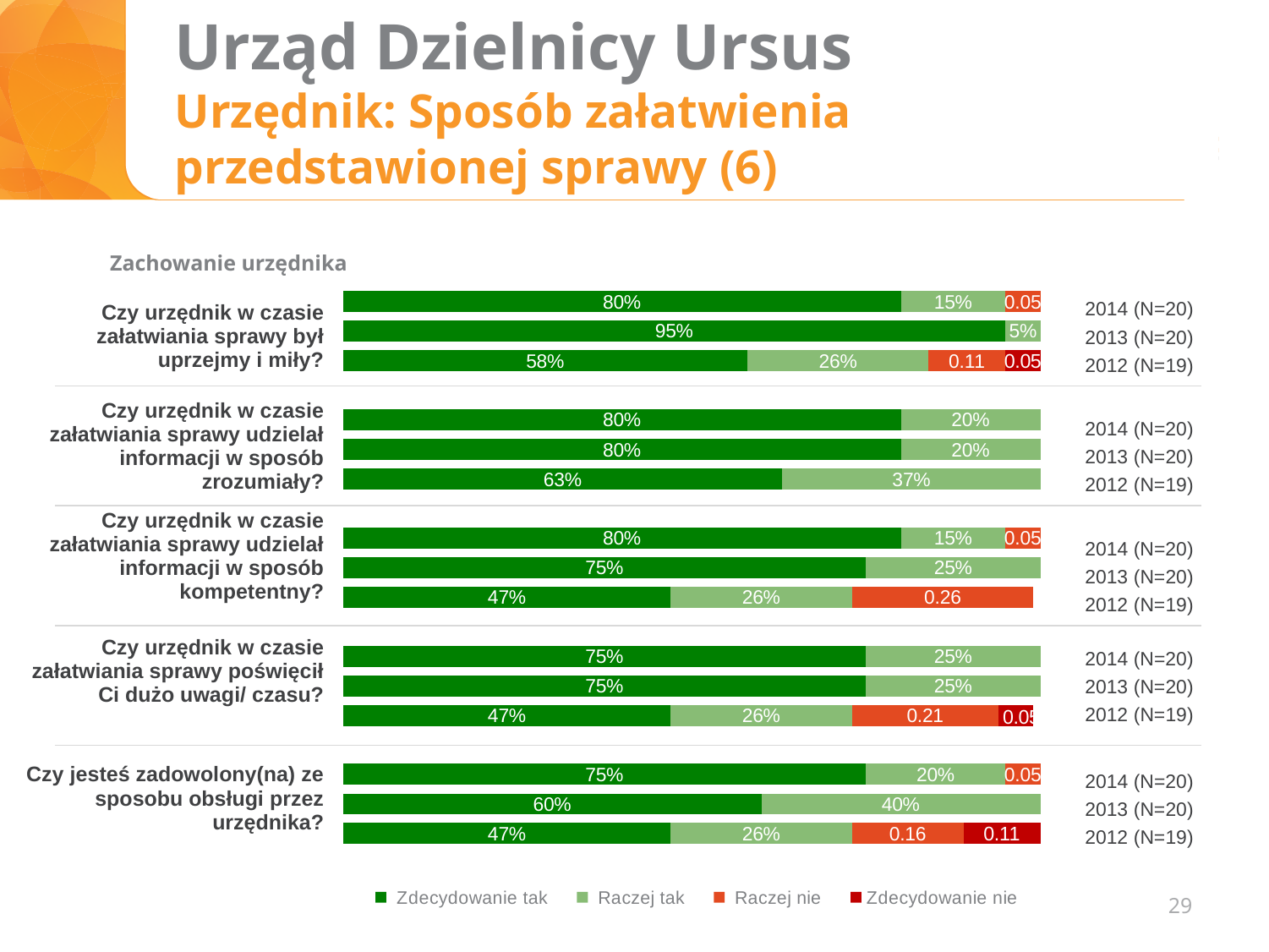
What kind of chart is used on this slide? Stacked bar chart In the chart for "Czy urzędnik w czasie załatwiania sprawy był uprzejmy i miły?", what is the "Zdecydowanie tak" value for 2013 (N=20)? 95% In the chart for "Czy urzędnik w czasie załatwiania sprawy udzielał informacji w sposób kompetentny?", which is larger: the "Zdecydowanie tak" value for 2014 (N=20) or for 2013 (N=20)? 2014 (N=20) In the chart for "Czy urzędnik w czasie załatwiania sprawy udzielał informacji w sposób zrozumiały?", what is the "Raczej tak" value for 2012 (N=19)? 37% In the chart for "Czy urzędnik w czasie załatwiania sprawy udzielał informacji w sposób kompetentny?", what is the "Raczej nie" value for 2012 (N=19)? 0.26 How many bars are shown in the chart for "Czy urzędnik w czasie załatwiania sprawy poświęcił Ci dużo uwagi/ czasu?"? 3 How many series does the legend list? 4 In the chart for "Czy urzędnik w czasie załatwiania sprawy był uprzejmy i miły?", which year has the lowest "Zdecydowanie tak" value? 2012 (N=19) In the chart for "Czy jesteś zadowolony(na) ze sposobu obsługi przez urzędnika?", what is the difference between the "Zdecydowanie tak" values for 2014 (N=20) and 2013 (N=20)? 15% In the chart for "Czy jesteś zadowolony(na) ze sposobu obsługi przez urzędnika?", which year has the highest "Zdecydowanie tak" value? 2014 (N=20) In the chart for "Czy jesteś zadowolony(na) ze sposobu obsługi przez urzędnika?", what is the "Zdecydowanie nie" value for 2012 (N=19)? 0.11 In the chart for "Czy urzędnik w czasie załatwiania sprawy był uprzejmy i miły?", what is the "Raczej tak" value for 2012 (N=19)? 26%